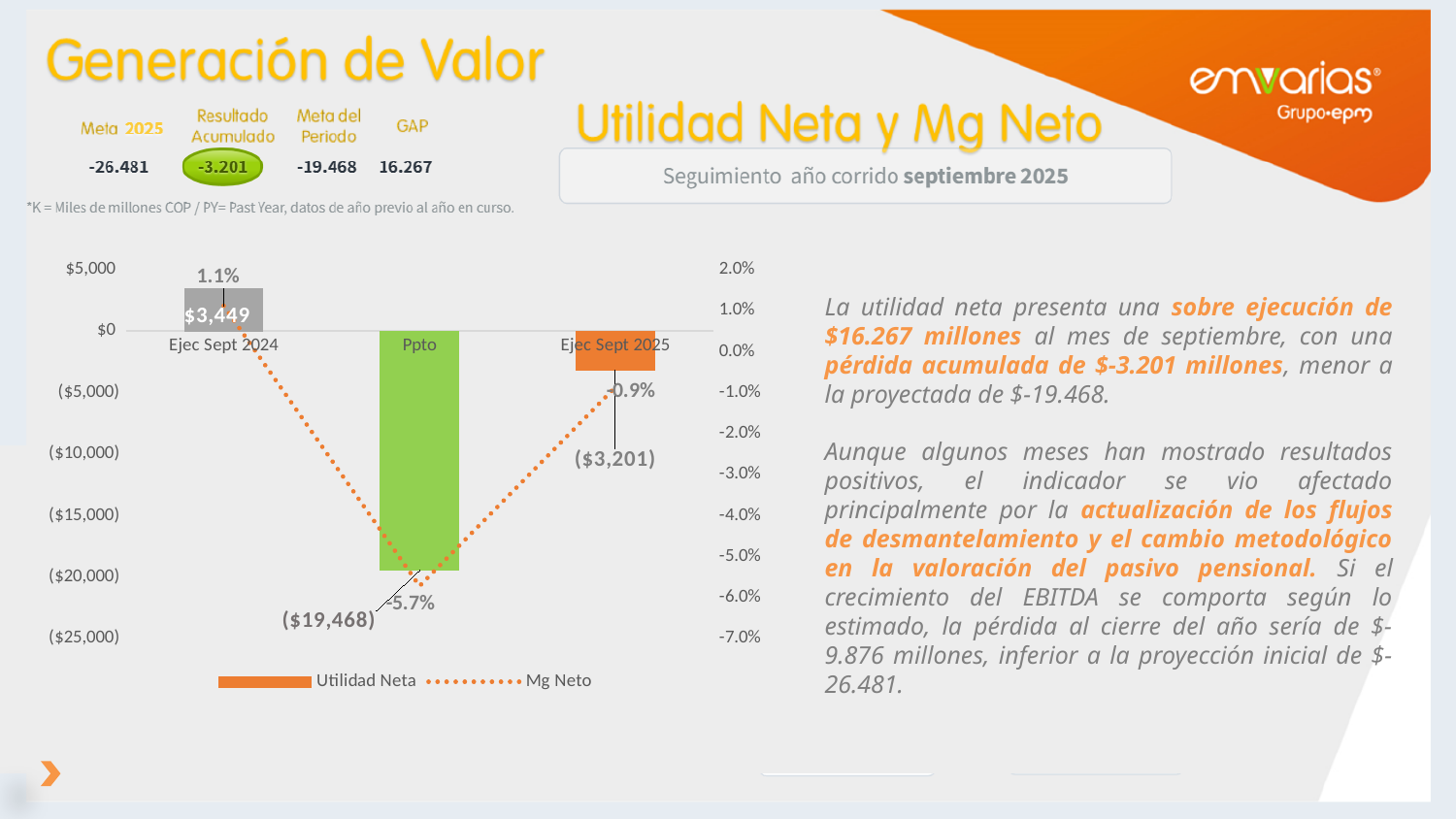
Which category has the highest Mg Neto? Ejec Sept 2024 What is the Utilidad Neta value for Ppto? ($19,468) What is the Mg Neto value for Ejec Sept 2025? -0.9% How many series does the chart legend list? 2 What is the Mg Neto value for Ppto? -5.7% Which series is drawn as a dotted line in the chart? Mg Neto What is the Utilidad Neta value for Ejec Sept 2024? $3,449 Is the Utilidad Neta for Ejec Sept 2025 larger or smaller than the Utilidad Neta for Ppto? larger What is the Mg Neto value for Ejec Sept 2024? 1.1% How many categories are shown on the x axis of the chart? 3 What is the Utilidad Neta value for Ejec Sept 2025? ($3,201) Which category has the lowest Utilidad Neta? Ppto